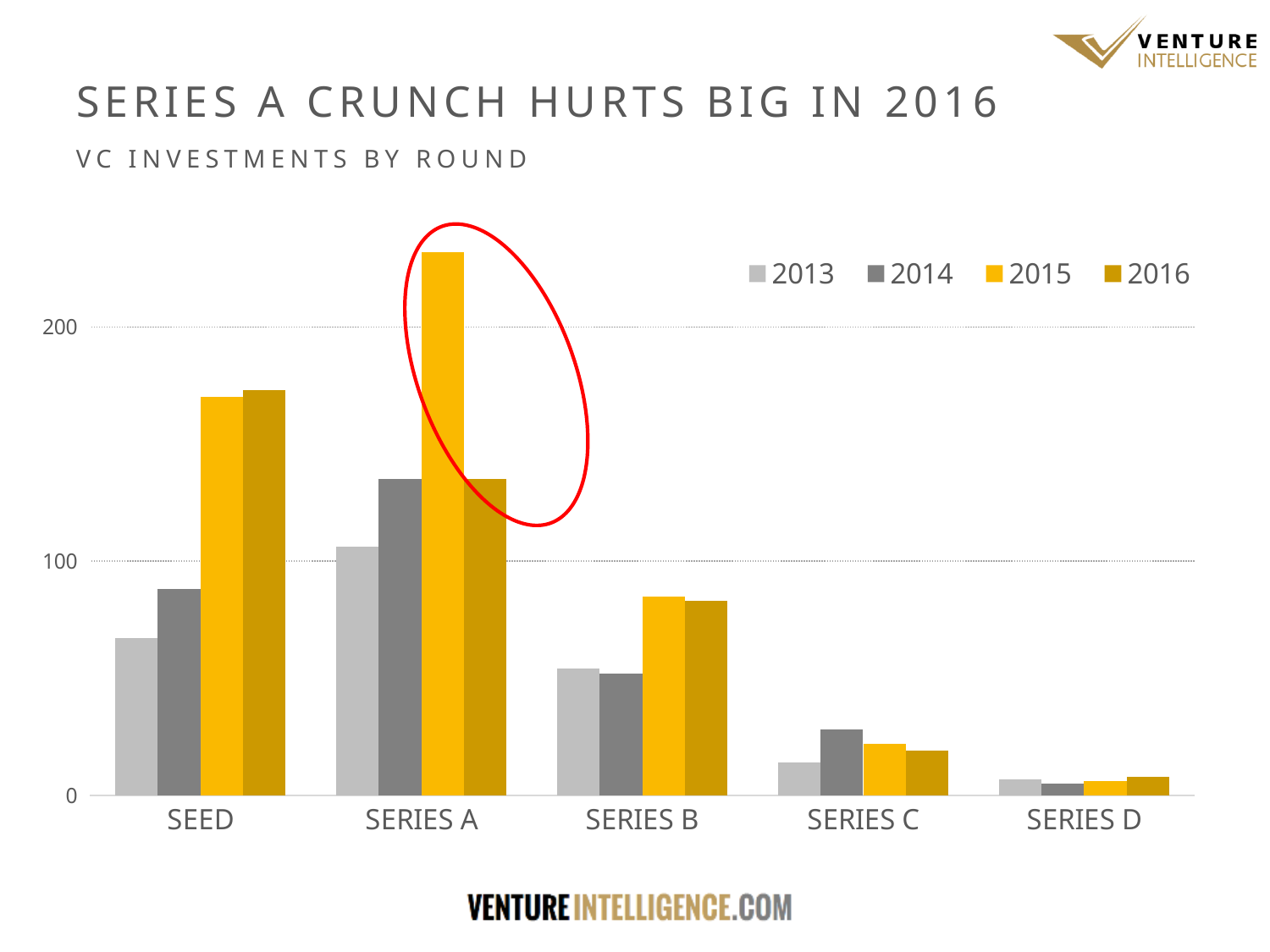
Is the 2016 value for Series B greater or less than 100? less What is the subtitle of the chart? VC Investments by Round What kind of chart is shown on the slide? Bar chart For Series A, which is larger: the 2015 value or the 2016 value? 2015 Is the 2015 value for Seed greater or less than 200? less Which round has the highest 2015 value? Series A Is the 2014 value for Seed greater or less than 100? less How many funding rounds are shown on the x axis? 5 Do the 2016 values rise or fall from Series A to Series D? fall Which round has the lowest 2016 value? Series D How many series does the legend list? 4